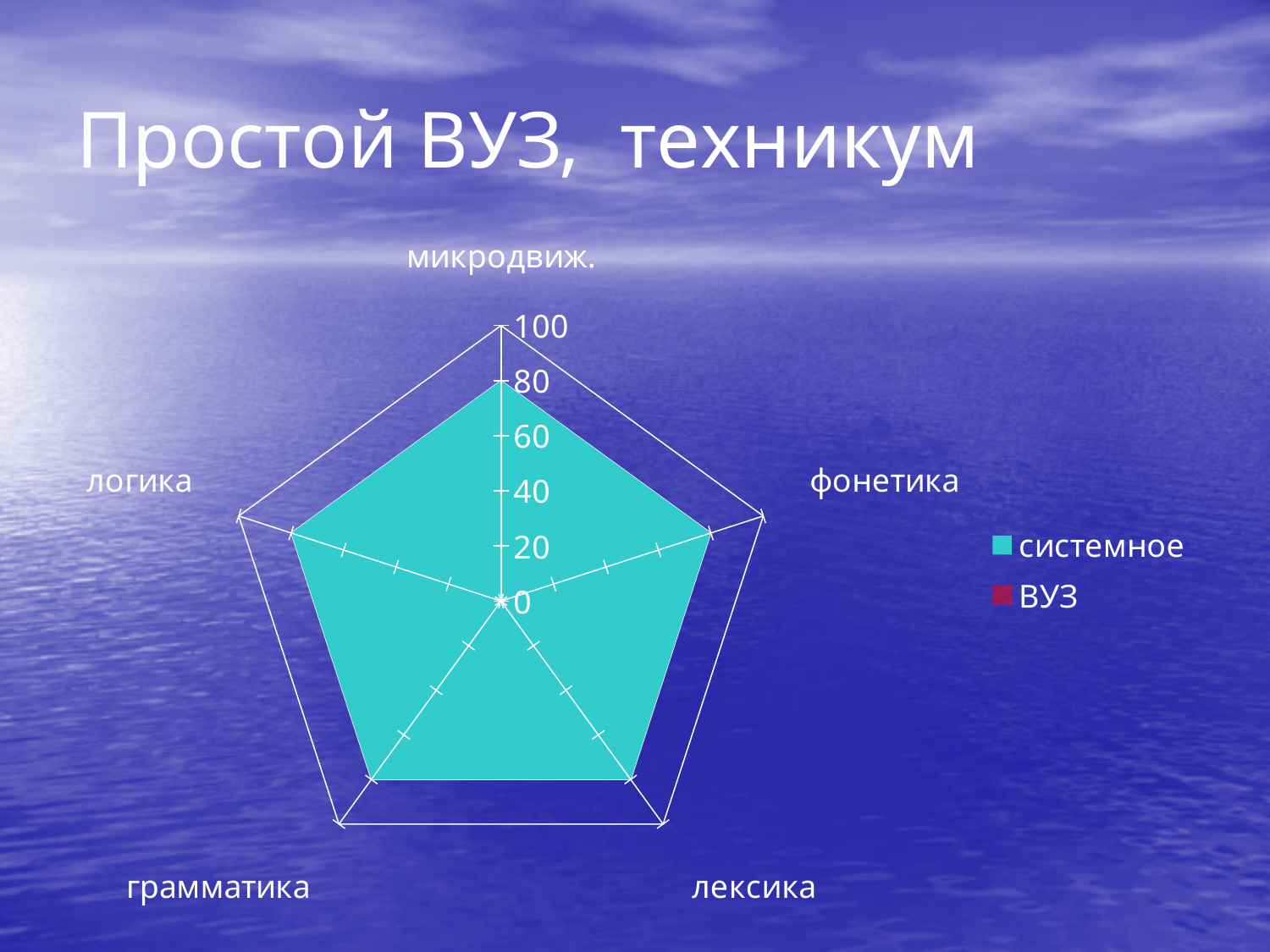
Which category label appears at the top of the radar chart? микродвиж. Which series is shown in turquoise in the legend? системное Is the системное value for логика greater or less than 100? less How many categories (axes) does the radar chart have? 5 What value does the системное series reach on the микродвиж. axis? 80 Is the системное value for лексика greater or less than 100? less What is the maximum value shown on the radar chart's axis scale? 100 How many series does the legend list? 2 Is the системное value for грамматика greater or less than 40? greater What kind of chart is shown on the slide? radar chart